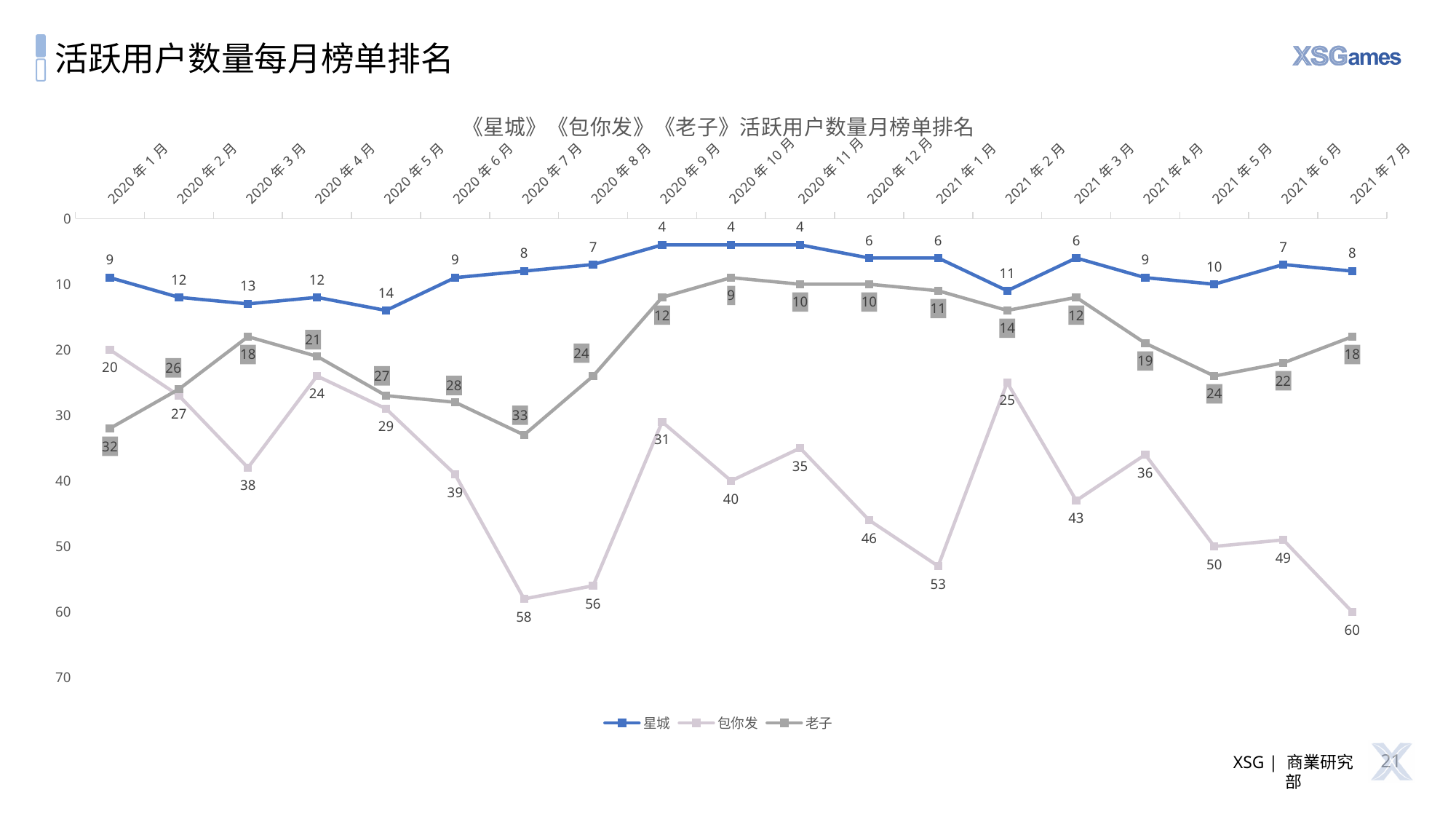
How many series does the legend list? 3 In which month does 包你发 have its smallest value? 2020年1月 In which month does 老子 have its smallest value? 2020年10月 What is the difference between the 包你发 value and the 星城 value in 2020年7月? 50 Which series has the larger value in 2020年1月, 老子 or 包你发? 老子 What is the value for 老子 in 2020年1月? 32 How many months are shown on the x axis? 19 What is the value for 包你发 in 2021年7月? 60 Do the values for 星城 rise or fall from 2020年5月 to 2020年9月? fall What kind of chart is shown on the slide? line chart What is the value for 星城 in 2020年9月? 4 In which month does 包你发 have its largest value? 2021年7月